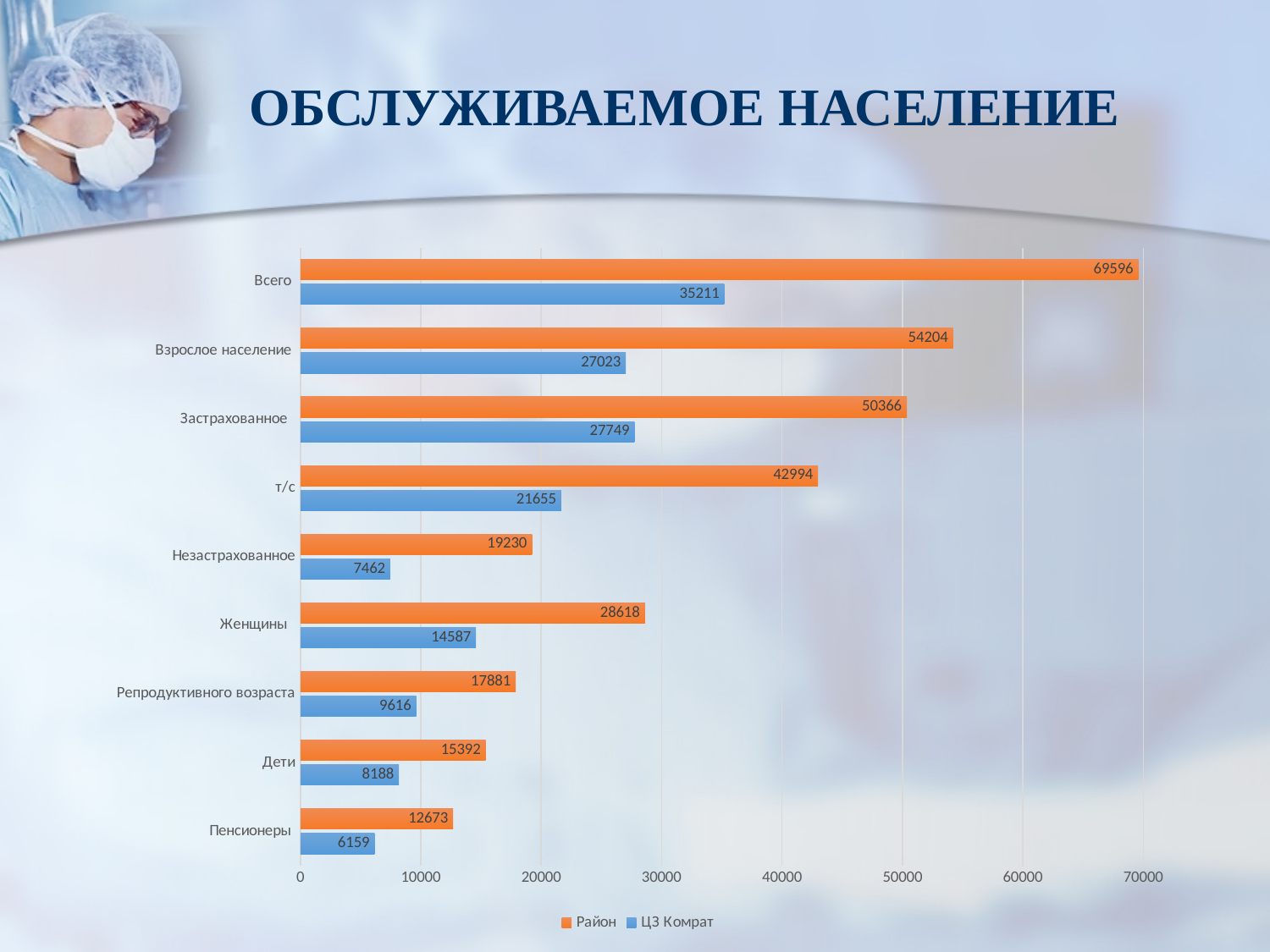
Which category has the highest value for ЦЗ Комрат? Всего What is the difference between the Район and ЦЗ Комрат values for Женщины? 14031 How many categories are shown on the chart? 9 Which category has the lowest value for Район? Пенсионеры What kind of chart is shown on the slide? bar chart What is the value for Район in the Всего category? 69596 What is the value for ЦЗ Комрат in the Дети category? 8188 What is the value for ЦЗ Комрат in the Застрахованное category? 27749 Which is larger: the ЦЗ Комрат value for Взрослое население or the ЦЗ Комрат value for Застрахованное? Застрахованное How many series does the legend list? 2 Which series is shown in orange? Район Is the Район value for т/с greater or less than 40000? greater